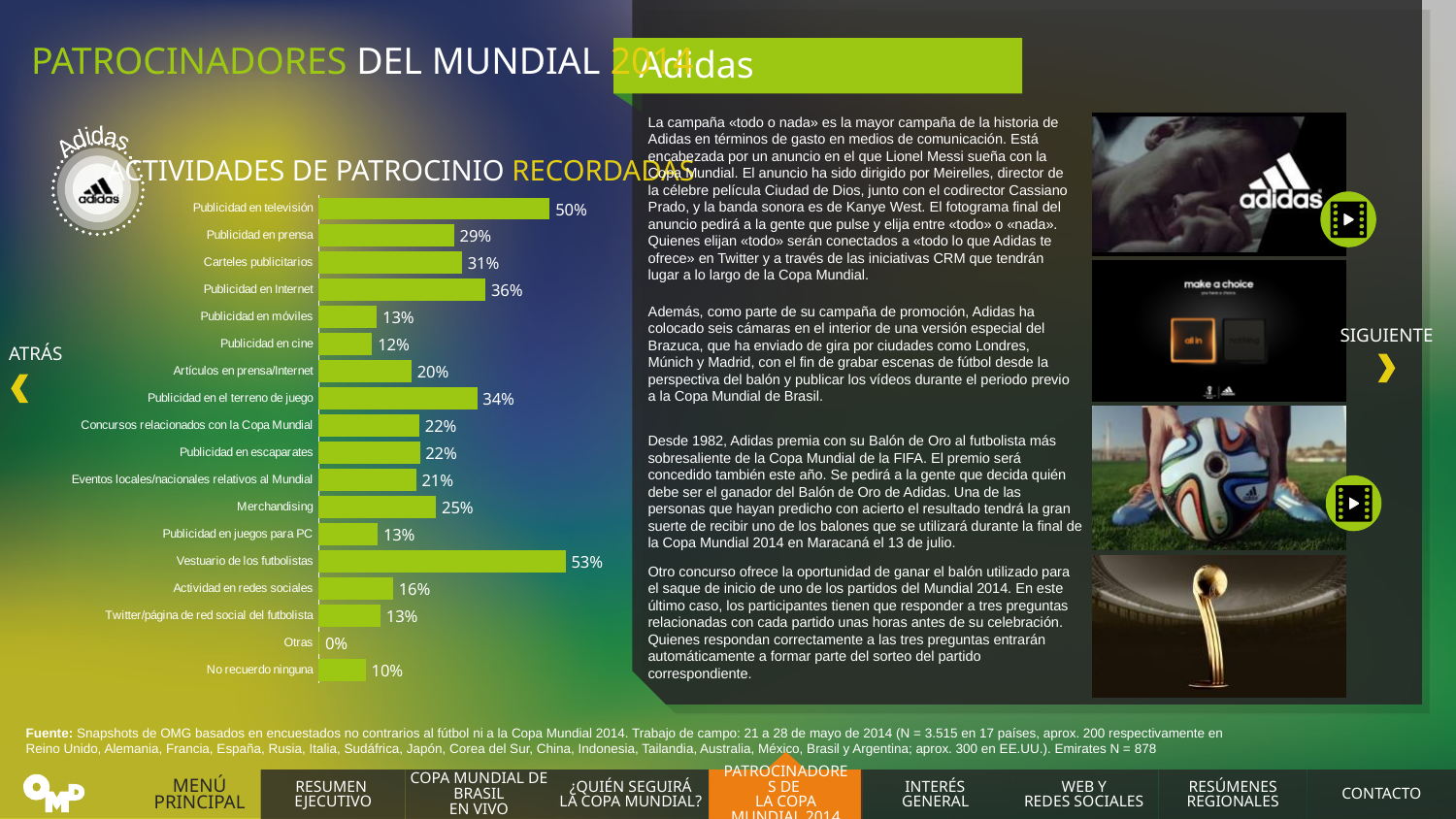
Which is larger, Publicidad en Internet or Publicidad en el terreno de juego? Publicidad en Internet What is the value for Merchandising? 25% What is the difference between Vestuario de los futbolistas and Actividad en redes sociales? 37% What is the title of the chart? ACTIVIDADES DE PATROCINIO RECORDADAS What is the difference between Publicidad en televisión and Publicidad en prensa? 21% What is the value for Publicidad en televisión? 50% What is the value for No recuerdo ninguna? 10% Which category has the highest value? Vestuario de los futbolistas What kind of chart is shown? Bar chart How many categories are shown in the chart? 18 What is the value for Vestuario de los futbolistas? 53% Which category has the lowest value? Otras